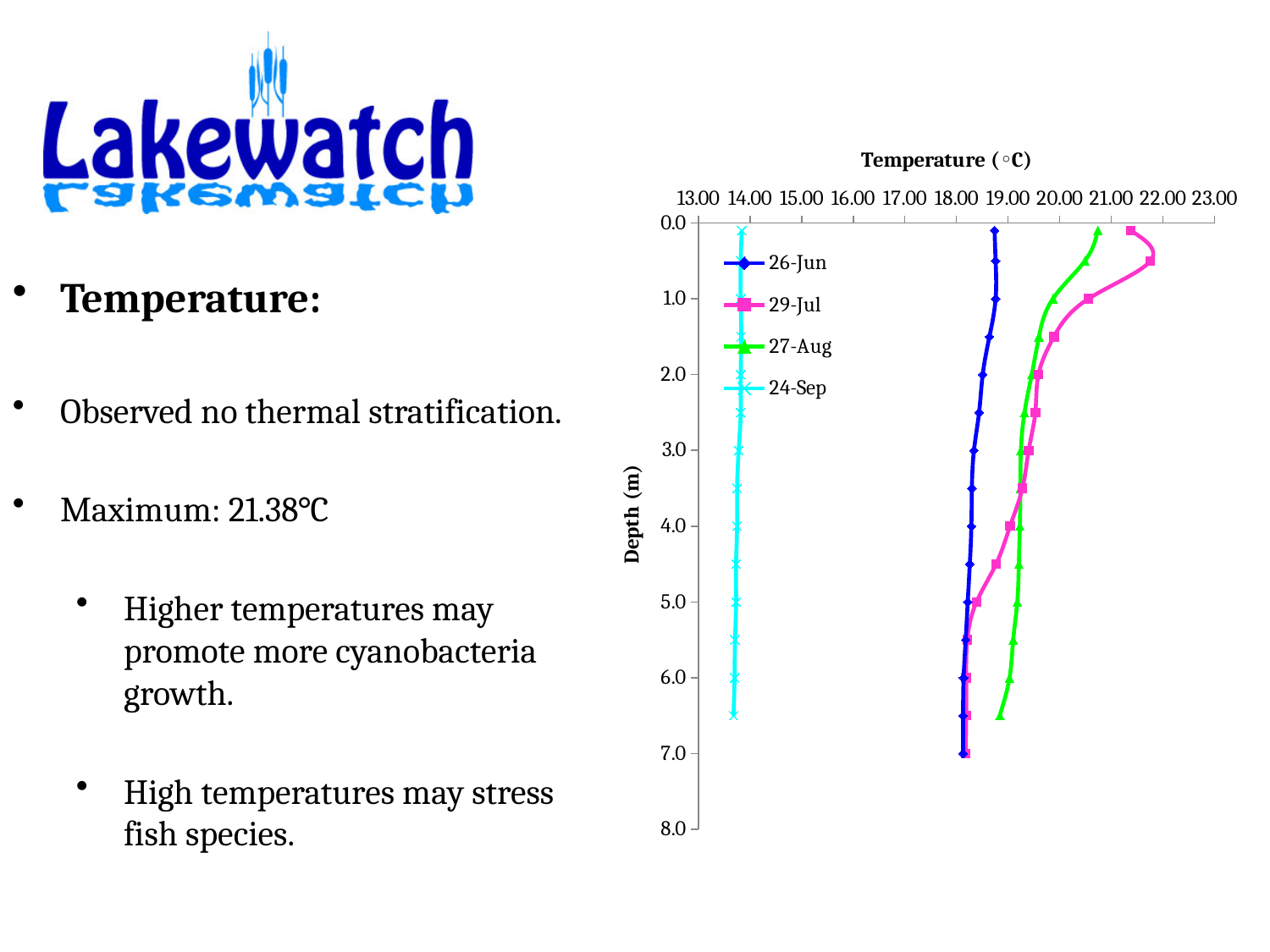
Is the temperature for 26-Jun at a depth of 0.0 m greater or less than 18.00? greater Which series reaches the highest temperature on the chart? 29-Jul Does the temperature for 29-Jul rise or fall as depth increases? fall At a depth of 3.0 m, which series has the higher temperature, 27-Aug or 24-Sep? 27-Aug Which series has the lowest temperatures across all depths? 24-Sep What is the label of the vertical axis of the chart? Depth (m) What kind of chart is shown on the slide? line chart Is the temperature for 24-Sep at a depth of 2.0 m greater or less than 15.00? less Is the temperature for 29-Jul at a depth of 0.5 m greater or less than 21.00? greater How many series does the chart legend list? 4 What is the label of the horizontal axis of the chart? Temperature (°C) At a depth of 0.0 m, which series has the higher temperature, 26-Jun or 29-Jul? 29-Jul